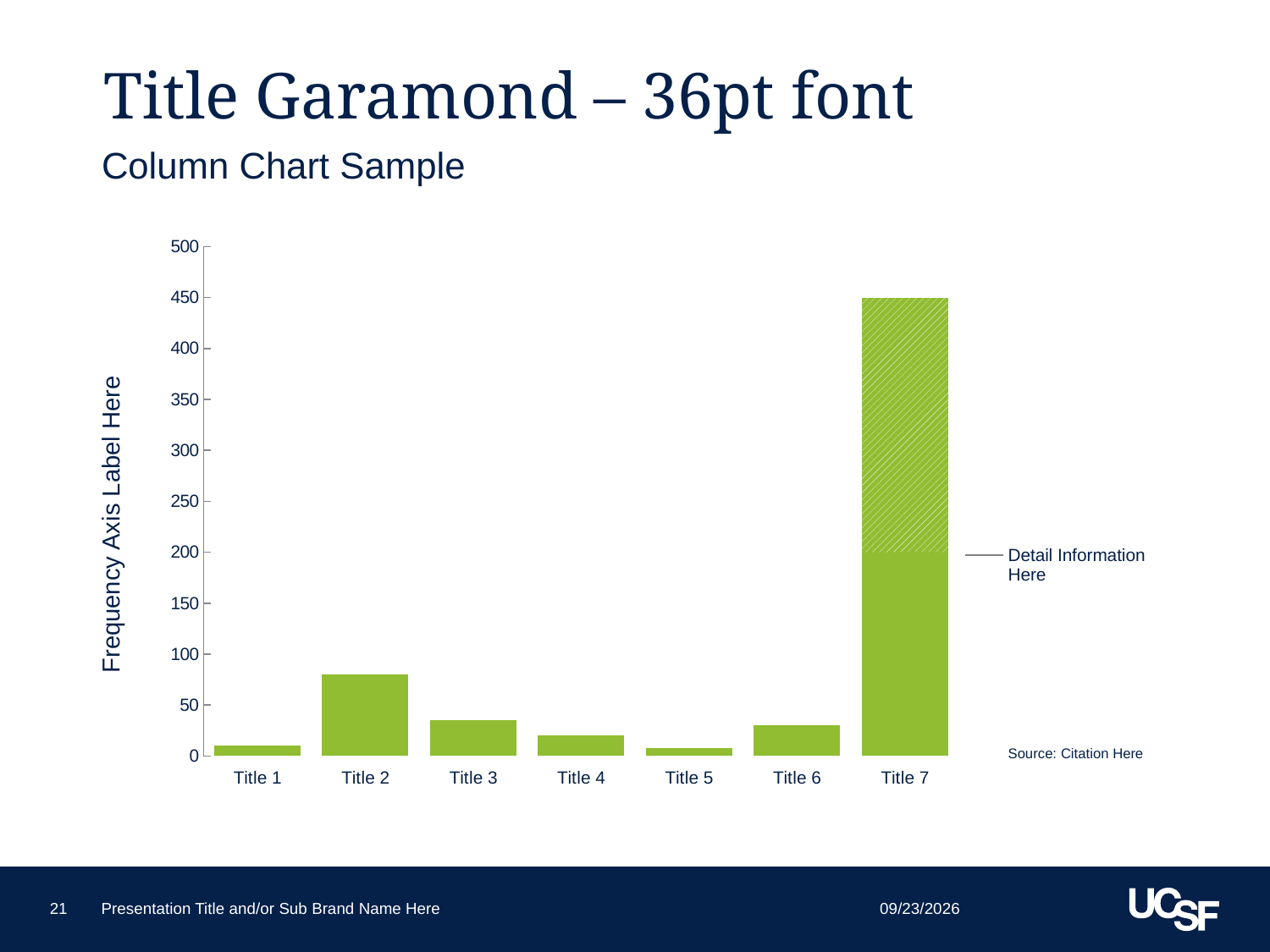
How many categories are shown on the x axis of the chart? 7 What is the value for Title 7? 450 Is the value for Title 2 greater or less than 50? greater Is the value for Title 1 greater or less than 50? less Is the value for Title 3 greater or less than 50? less Which is larger, the value for Title 6 or the value for Title 7? Title 7 Which category has the highest value in the chart? Title 7 What type of chart is shown on the slide? bar chart What text does the annotation pointing to the Title 7 bar show? Detail Information Here What is the label on the vertical axis of the chart? Frequency Axis Label Here Which is larger, the value for Title 2 or the value for Title 3? Title 2